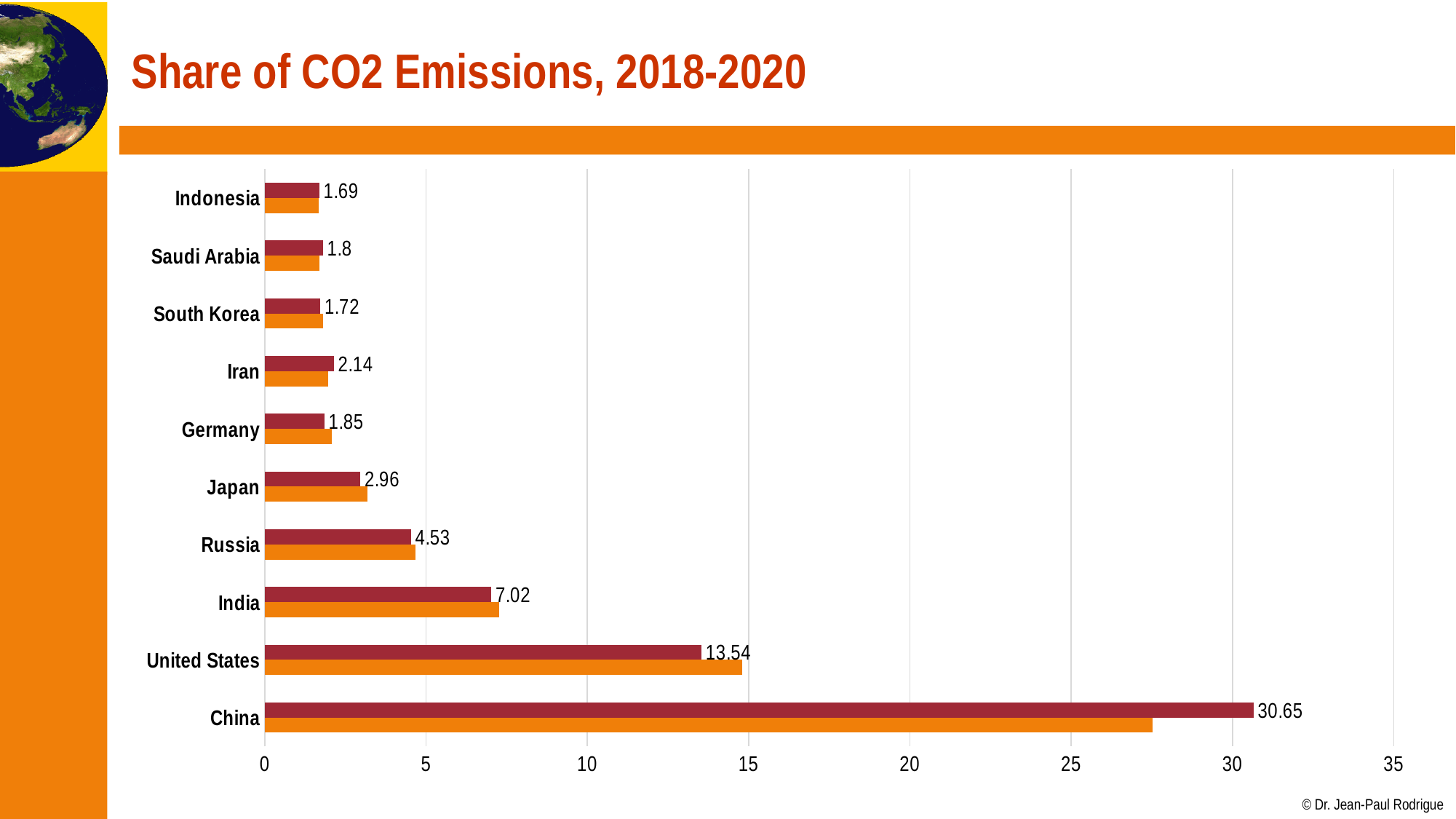
What is the title of the chart? Share of CO2 Emissions, 2018-2020 What is the difference between the labelled values for China and the United States? 17.11 How many countries are shown on the chart? 10 What is the labelled value for the United States? 13.54 Which country has the lowest labelled value? Indonesia Which has the larger labelled value, India or Japan? India What is the labelled value for Iran? 2.14 What kind of chart is shown on the slide? bar chart Which country has the highest labelled value? China What is the labelled value for Russia? 4.53 What is the labelled value for China? 30.65 Is the value of the orange bar for China greater or less than 30? less